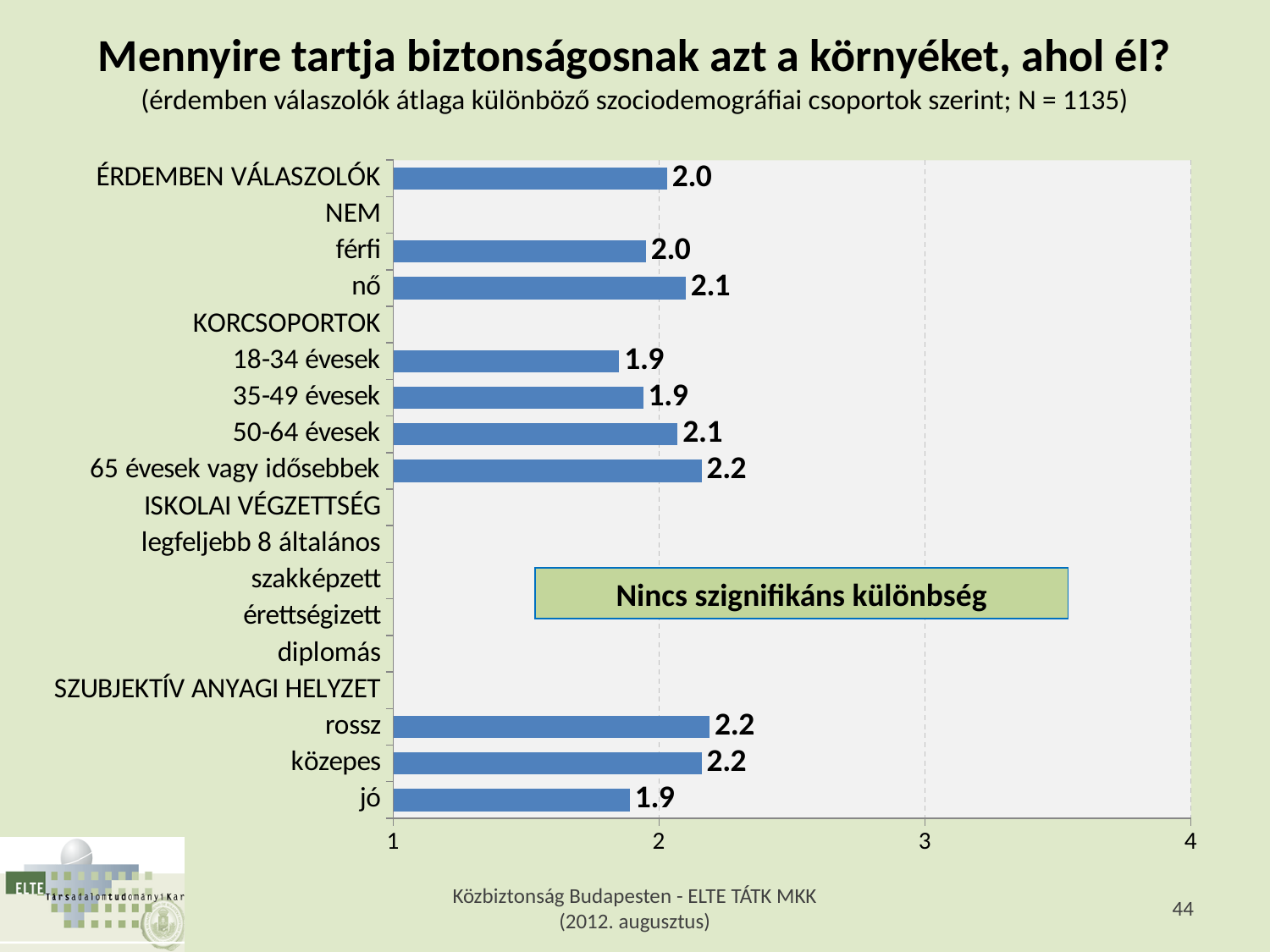
What is the value for 'jó'? 1.9 What is the value for '50-64 évesek'? 2.1 What is the value for 'nő'? 2.1 Which has a larger value, 'rossz' or 'jó'? rossz Is the value for 'közepes' greater or less than 3? less What is the value for 'ÉRDEMBEN VÁLASZOLÓK'? 2.0 What text is shown in the box placed over the education (ISKOLAI VÉGZETTSÉG) categories? Nincs szignifikáns különbség What is the difference between the values for '65 évesek vagy idősebbek' and '18-34 évesek'? 0.3 What kind of chart is shown on the slide? bar chart Which has a larger value, 'nő' or 'férfi'? nő What is the value for '65 évesek vagy idősebbek'? 2.2 How many bars are plotted on the chart? 10